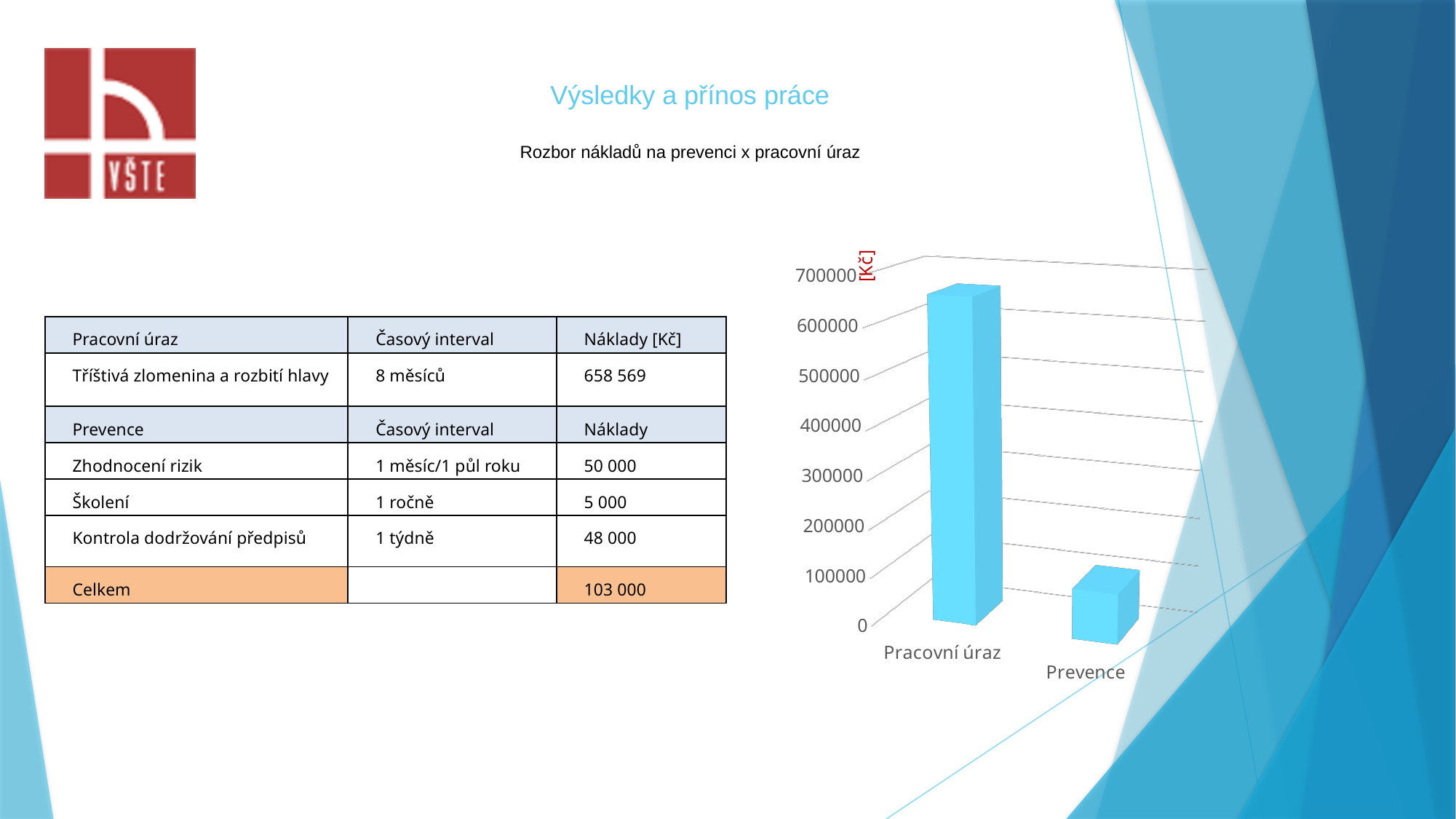
Is the value for Prevence in the chart greater or less than 300000? less Which category has the lowest bar in the chart? Prevence Which category has the highest bar in the chart? Pracovní úraz What kind of chart is shown on the slide? bar chart How many categories are plotted in the chart? 2 What unit is shown on the vertical axis of the chart? [Kč] Is the value for Pracovní úraz in the chart greater or less than 500000? greater Which is larger in the chart, the value for Pracovní úraz or the value for Prevence? Pracovní úraz What is the highest tick value shown on the vertical axis of the chart? 700000 Is the value for Prevence in the chart greater or less than 200000? less